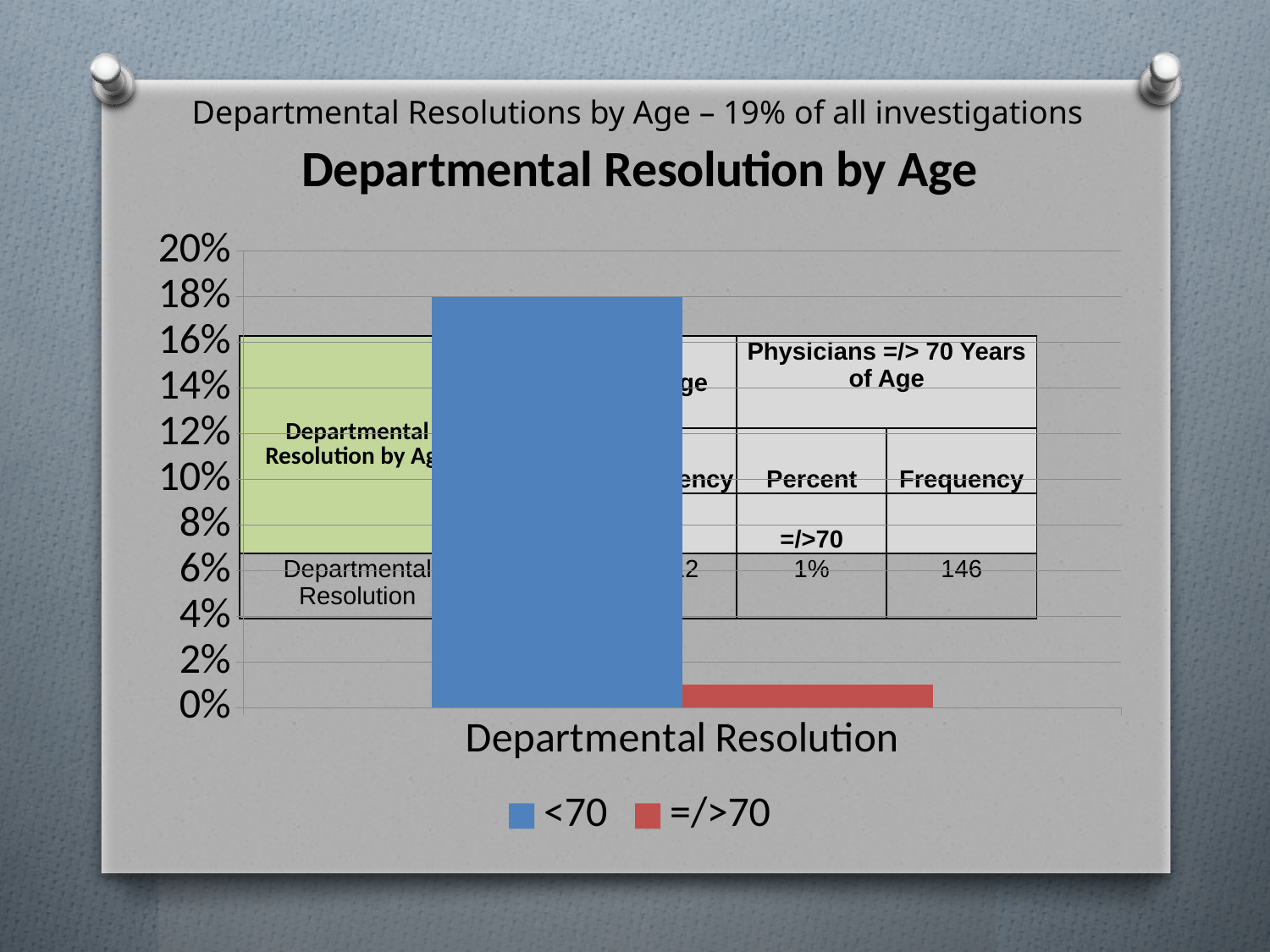
Is the value for the =/>70 series greater or less than 2%? less Which series has the highest value in the chart? <70 What kind of chart is shown on the slide? bar chart What are the two series named in the chart legend? <70 and =/>70 Is the value for the <70 series greater or less than 16%? greater How many categories are shown on the x axis of the chart? 1 Which series has the taller bar for Departmental Resolution, <70 or =/>70? <70 According to the table overlaid on the chart, what is the percent for physicians =/>70 years of age? 1% How many series does the legend of the chart list? 2 What is the title of the chart? Departmental Resolution by Age Is the value for the <70 series greater or less than 20%? less Which series has the lowest value in the chart? =/>70